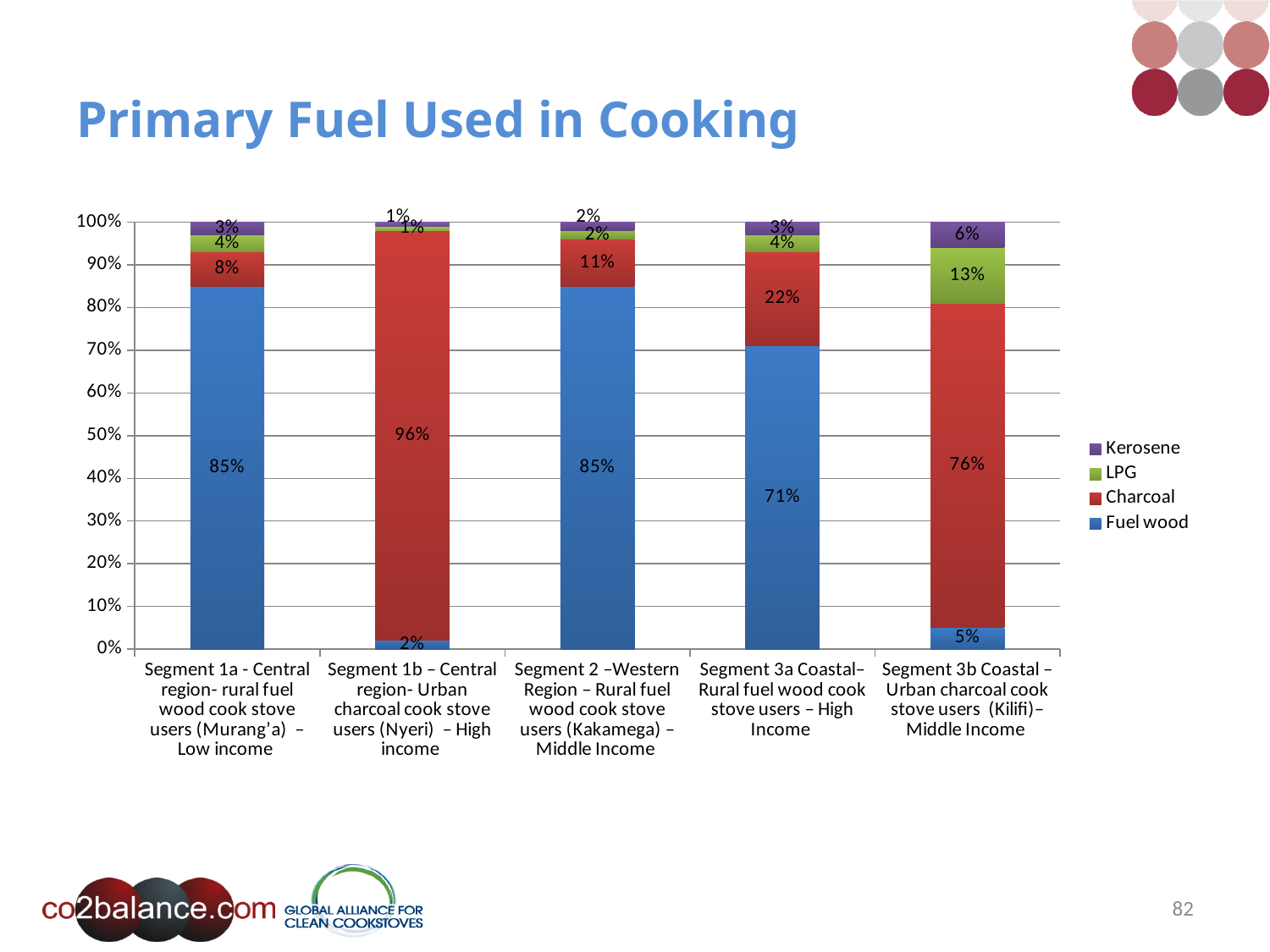
What is the Charcoal share for Segment 3a Coastal - Rural fuel wood cook stove users - High Income? 22% What is the Charcoal share for Segment 1b - Central region - Urban charcoal cook stove users (Nyeri) - High income? 96% How many series does the legend list? 4 Which segment has the highest Charcoal share? Segment 1b - Central region - Urban charcoal cook stove users (Nyeri) - High income Which colour represents Charcoal in the chart? Red What is the LPG share for Segment 3b Coastal - Urban charcoal cook stove users (Kilifi) - Middle Income? 13% What kind of chart is shown on the slide? Stacked bar chart What is the difference between the Fuel wood share of Segment 1a (Murang'a) and Segment 3a Coastal - High Income? 14% Which segment has the lowest Fuel wood share? Segment 1b - Central region - Urban charcoal cook stove users (Nyeri) - High income Which is larger: the Kerosene share for Segment 3b Coastal (Kilifi) or the Kerosene share for Segment 1a (Murang'a)? Segment 3b Coastal (Kilifi) How many segments are shown on the x axis? 5 What is the Fuel wood share for Segment 1a - Central region - rural fuel wood cook stove users (Murang'a) - Low income? 85%